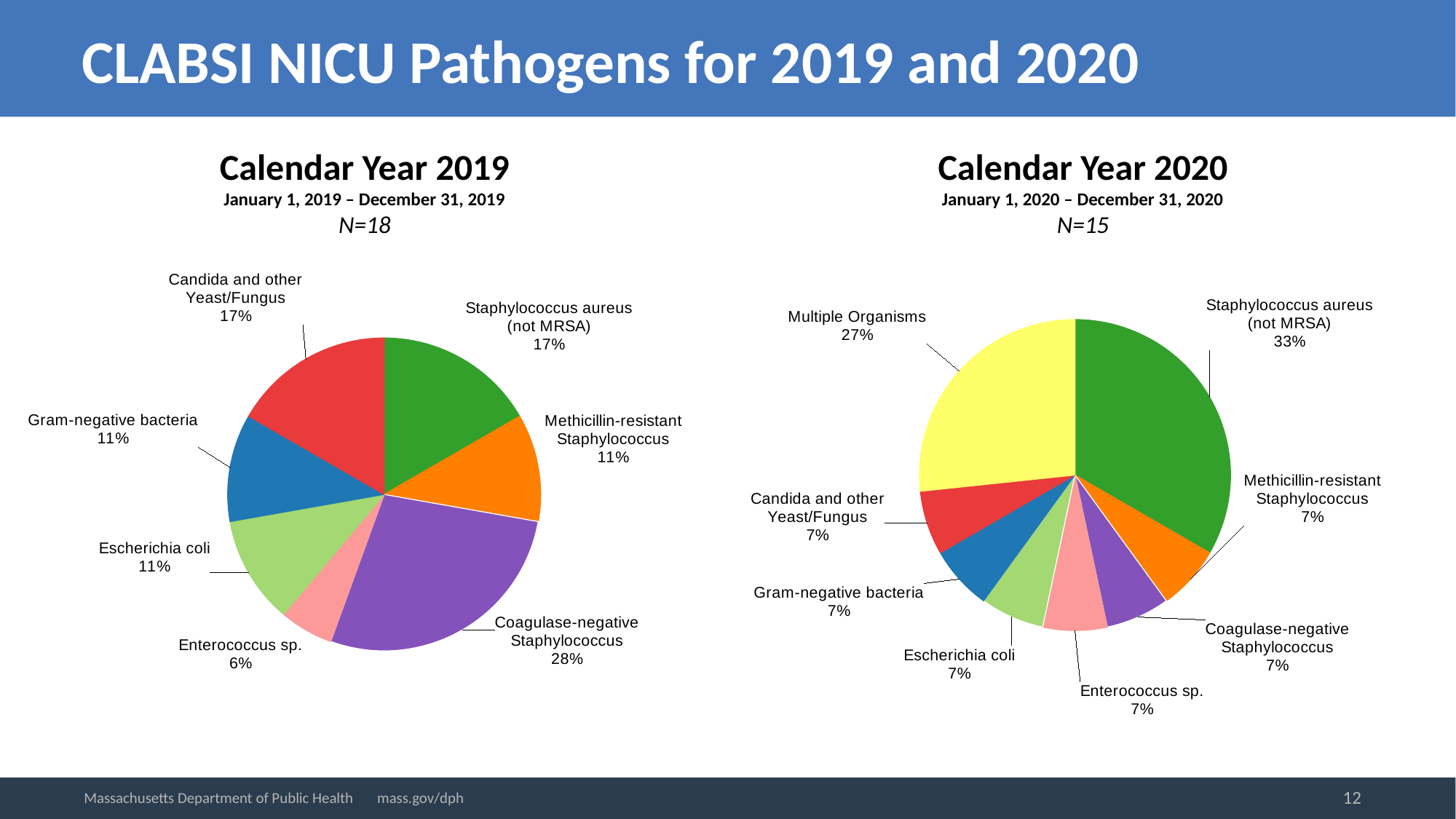
In the Calendar Year 2019 pie chart, which pathogen has the largest share? Coagulase-negative Staphylococcus In the Calendar Year 2019 pie chart, which pathogen has the smallest share? Enterococcus sp. In the Calendar Year 2020 pie chart, what share does Staphylococcus aureus (not MRSA) have? 33% What type of chart is used for Calendar Year 2019? Pie chart In the Calendar Year 2020 pie chart, what is the difference between the shares of Staphylococcus aureus (not MRSA) and Multiple Organisms? 6 percentage points In the Calendar Year 2020 pie chart, what share does Multiple Organisms have? 27% In the Calendar Year 2019 pie chart, what is the difference between the shares of Coagulase-negative Staphylococcus and Enterococcus sp.? 22 percentage points How many slices does the Calendar Year 2020 pie chart have? 8 How many slices does the Calendar Year 2019 pie chart have? 7 Which is larger: the share of Staphylococcus aureus (not MRSA) in the Calendar Year 2019 chart or in the Calendar Year 2020 chart? Calendar Year 2020 In the Calendar Year 2019 pie chart, what share does Coagulase-negative Staphylococcus have? 28% In the Calendar Year 2020 pie chart, which pathogen has the largest share? Staphylococcus aureus (not MRSA)